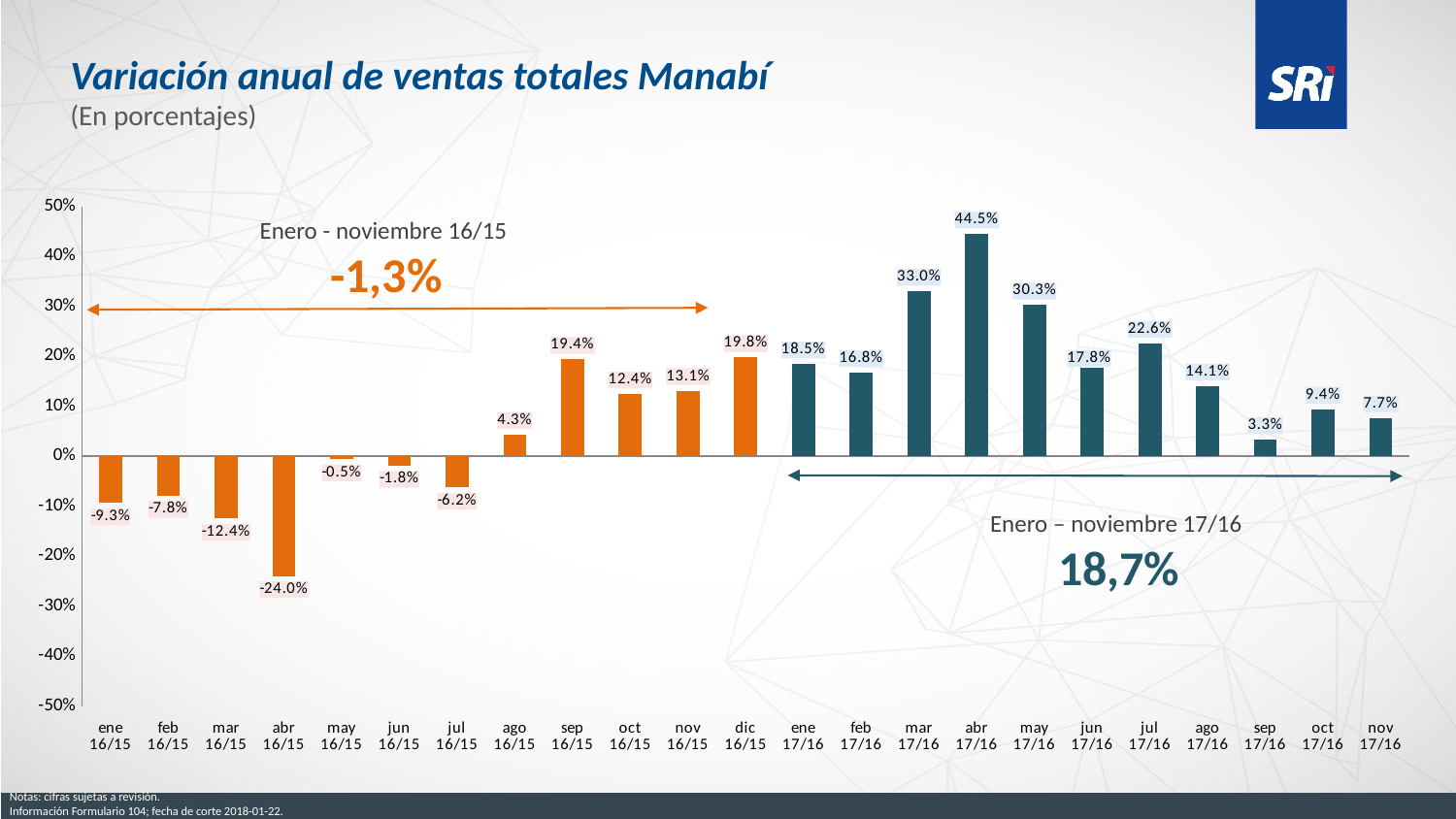
What is the title of the chart? Variación anual de ventas totales Manabí What is the difference between the values for mar 17/16 and mar 16/15? 45.4 percentage points How many months are plotted on the chart? 23 What is the cumulative variation shown for Enero - noviembre 17/16? 18,7% What is the value for abr 16/15? -24.0% What is the value for abr 17/16? 44.5% What is the value for nov 17/16? 7.7% Which month has the highest value? abr 17/16 Which is larger, the value for sep 16/15 or the value for sep 17/16? sep 16/15 Which month has the lowest value? abr 16/15 What kind of chart is shown? Bar chart Is the value for may 17/16 greater or less than 20%? greater